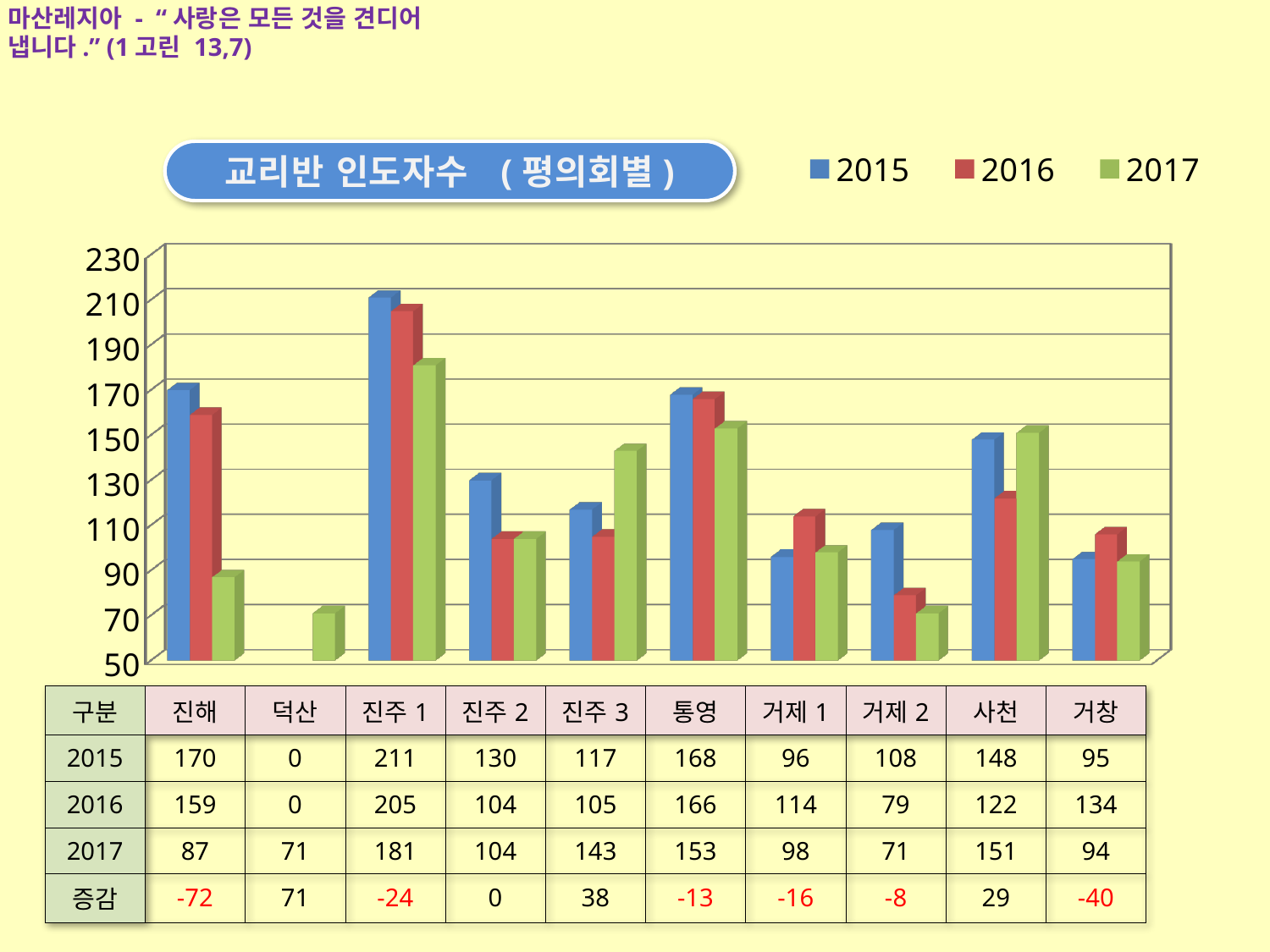
What is the 2017 value for 사천? 151 What is the 2015 value for 진주 1? 211 Is the 2016 value for 통영 greater or less than 150? greater Which category has the lowest 2017 value? 덕산 and 거제 2 (both 71) What type of chart is shown on the slide? bar chart What is the title of the chart? 교리반 인도자수 (평의회별) Which is larger for 진주 3: the 2015 value or the 2017 value? 2017 What is the difference between the 2015 and 2017 values for 진해? 83 How many series does the legend list? 3 How many categories (평의회) are shown along the x axis? 10 What is the 2016 value for 거제 2? 79 Which category has the highest 2015 value? 진주 1